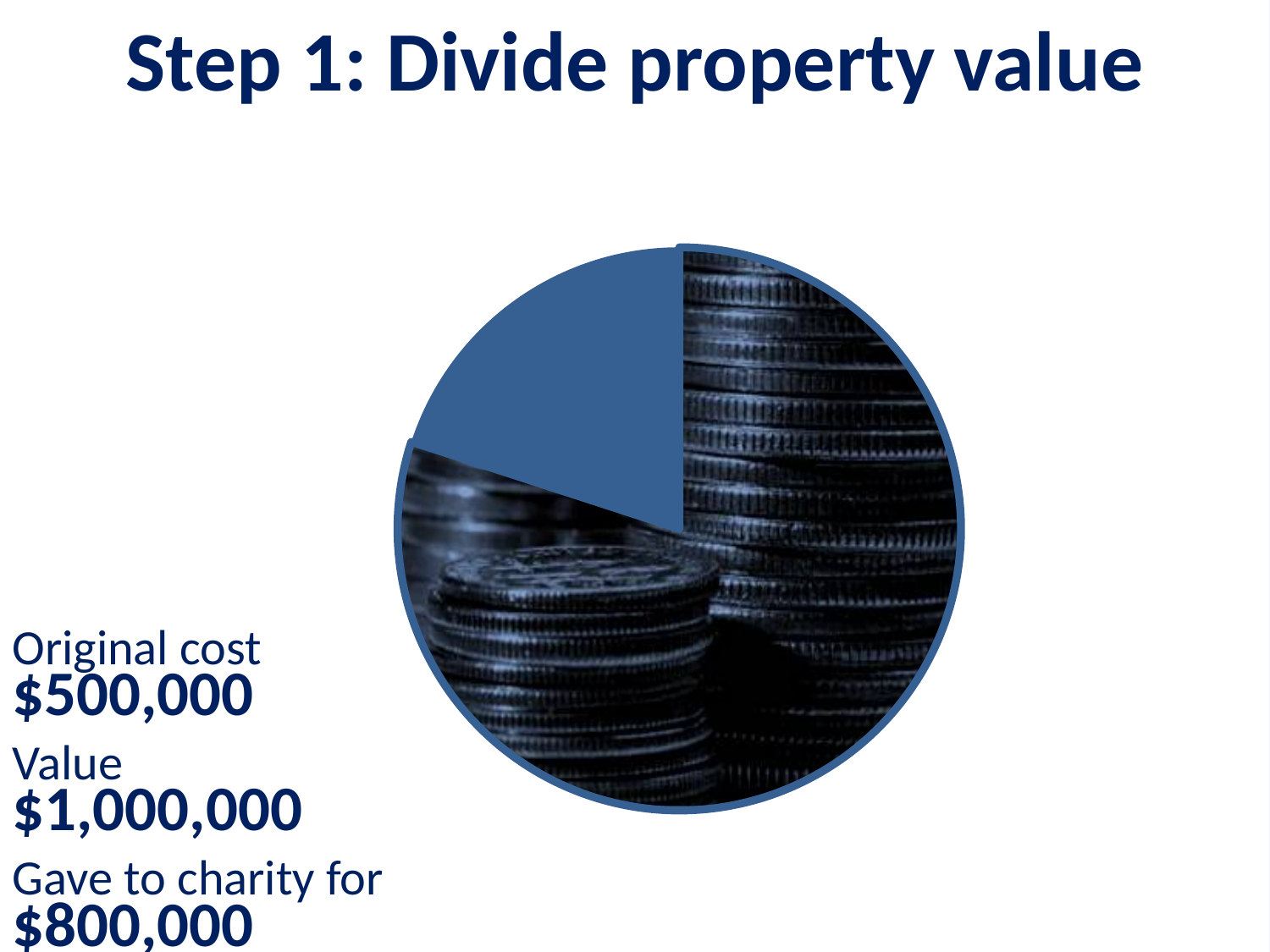
Which slice of the pie chart is larger, the solid blue slice or the slice filled with the image of coins? the slice filled with the image of coins What kind of chart is shown on the slide? pie chart What colour is the smaller slice of the pie chart? blue How many slices does the pie chart have? 2 What is the title shown above the pie chart? Step 1: Divide property value Is the solid blue slice of the pie chart more or less than half of the pie? less